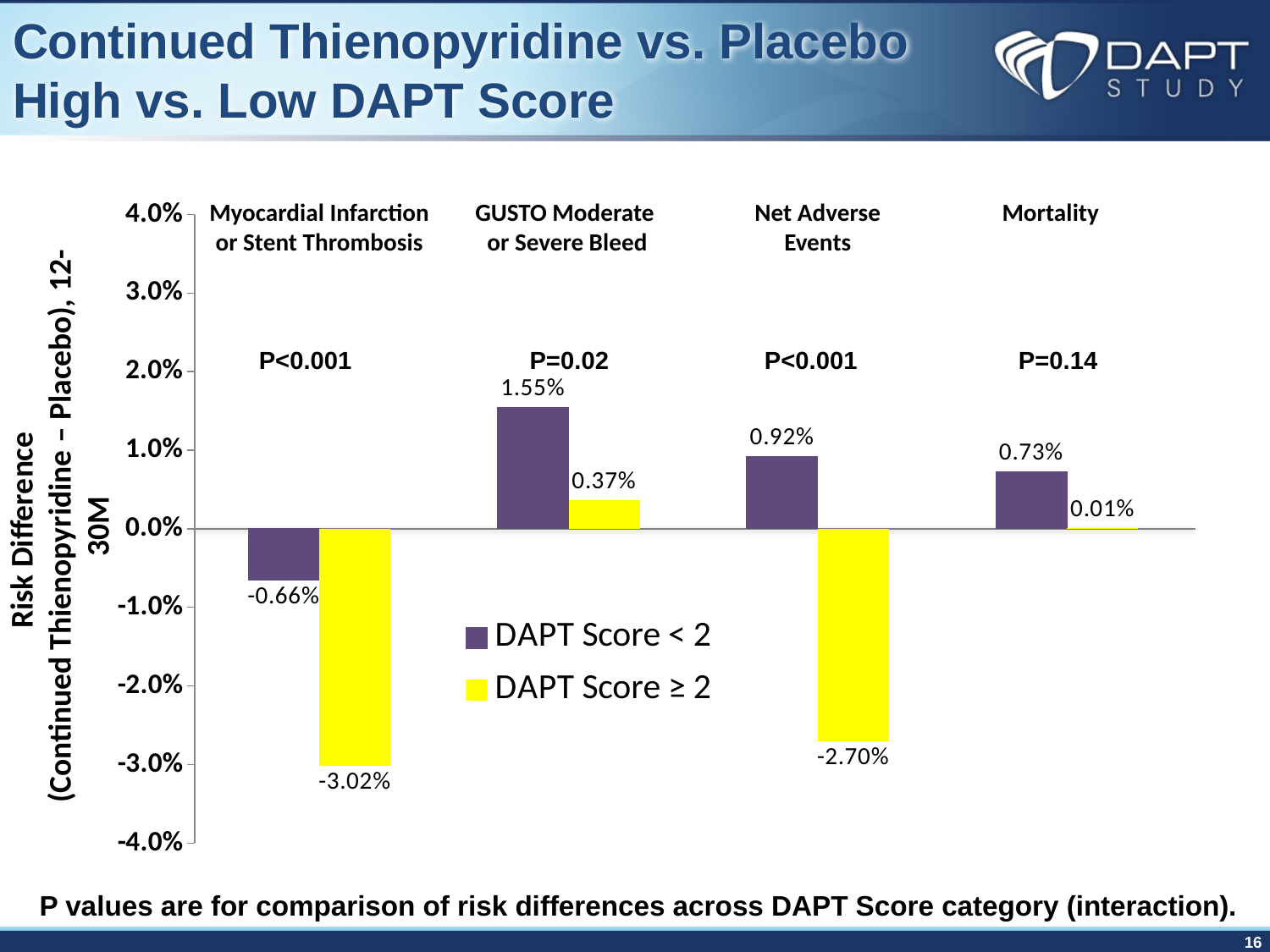
What is the risk difference for DAPT Score < 2 in the Mortality category? 0.73% What is the risk difference for DAPT Score < 2 in the GUSTO Moderate or Severe Bleed category? 1.55% What is the risk difference for DAPT Score ≥ 2 in the Net Adverse Events category? -2.70% Which category has the highest risk difference for the DAPT Score < 2 series? GUSTO Moderate or Severe Bleed What is the difference between the DAPT Score < 2 and DAPT Score ≥ 2 values in the GUSTO Moderate or Severe Bleed category? 1.18 percentage points Which category has the lowest risk difference for the DAPT Score ≥ 2 series? Myocardial Infarction or Stent Thrombosis What is the difference between the DAPT Score < 2 and DAPT Score ≥ 2 values in the Net Adverse Events category? 3.62 percentage points What is the risk difference for DAPT Score ≥ 2 in the Myocardial Infarction or Stent Thrombosis category? -3.02% How many outcome categories are shown on the chart? 4 How many series does the legend list? 2 What kind of chart is shown on the slide? Bar chart In the Mortality category, which series has the larger risk difference, DAPT Score < 2 or DAPT Score ≥ 2? DAPT Score < 2